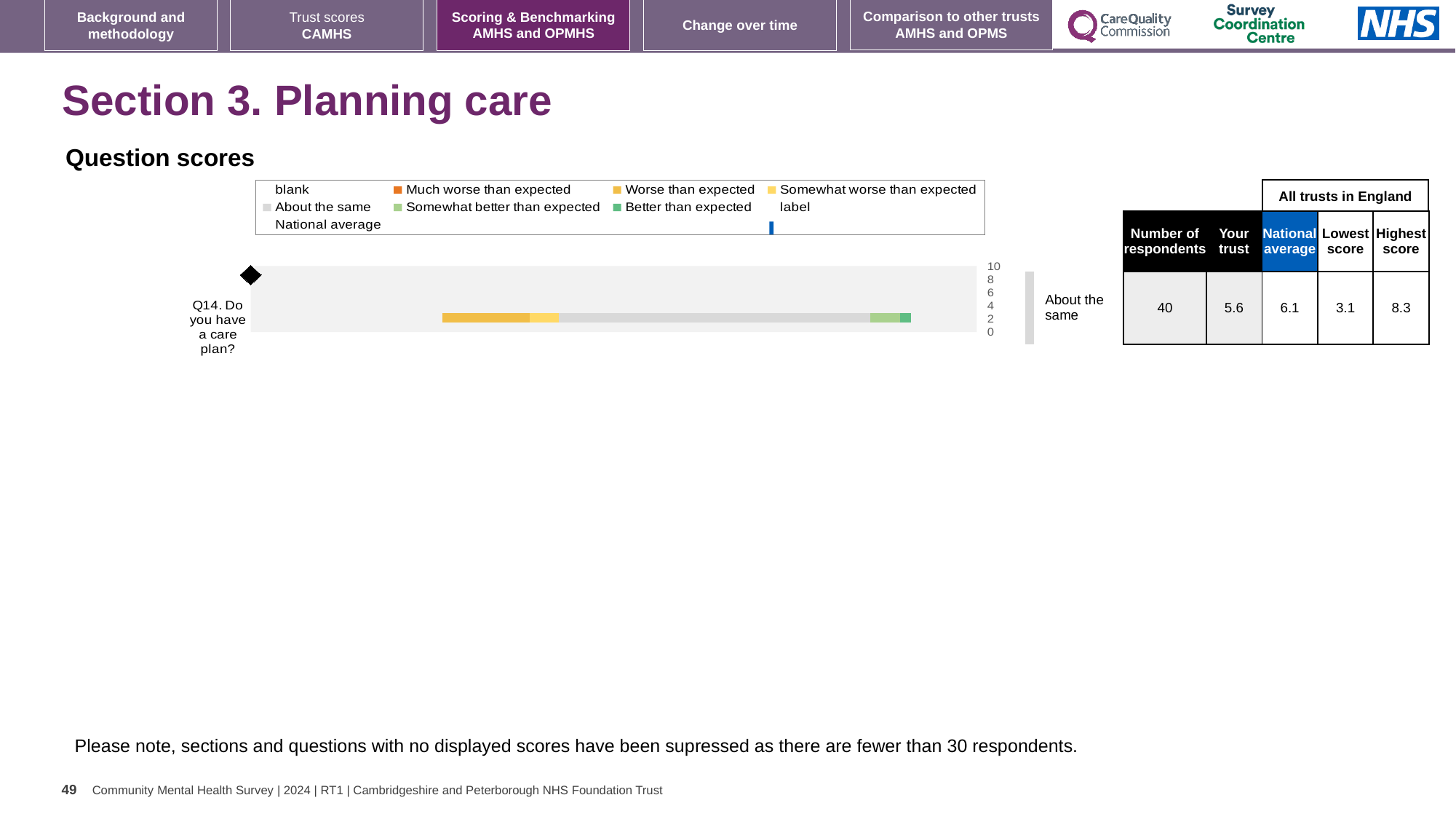
For Q14, what is the difference between the National average and the 'Your trust' score? 0.5 Which question is plotted in the Question scores chart? Q14. Do you have a care plan? In the table next to the chart, what is the Lowest score among all trusts in England for Q14? 3.1 What kind of chart is used to show the Q14 question score? bar chart For Q14, which is larger: the 'Your trust' score or the National average? National average What benchmark category label is shown next to the bar for Q14? About the same In the table next to the chart, what is the Highest score among all trusts in England for Q14? 8.3 How many questions are plotted in the Question scores chart? 1 In the table next to the chart, what is the 'Your trust' score for Q14? 5.6 In the table next to the chart, what is the National average score for Q14? 6.1 In the table next to the chart, how many respondents answered Q14? 40 For Q14, what is the difference between the Highest score and the Lowest score among all trusts in England? 5.2